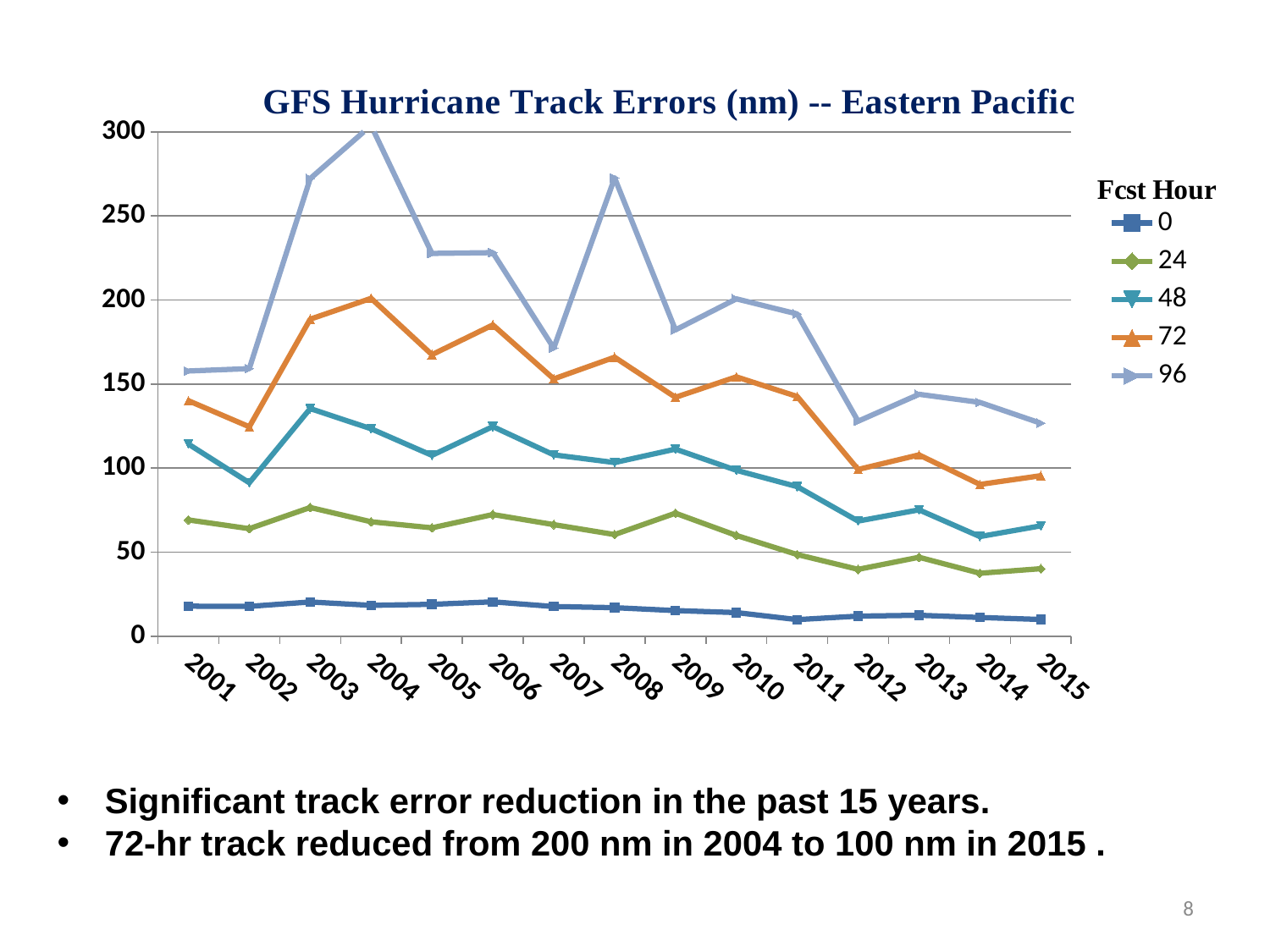
In which year is the 72-hour track error highest? 2004 Is the 96-hour track error in 2003 greater or less than 250? greater Which is larger, the 96-hour track error in 2004 or in 2008? 2004 In which year is the 48-hour track error lowest? 2014 What kind of chart is shown on the slide? line chart Does the 0-hour track error generally rise or fall from 2001 to 2015? fall How many series does the legend list? 5 In which year is the 96-hour track error highest? 2004 What is the title of the chart? GFS Hurricane Track Errors (nm) -- Eastern Pacific What is the title of the legend? Fcst Hour How many years are plotted along the x axis? 15 Is the 24-hour track error in 2014 greater or less than 50? less